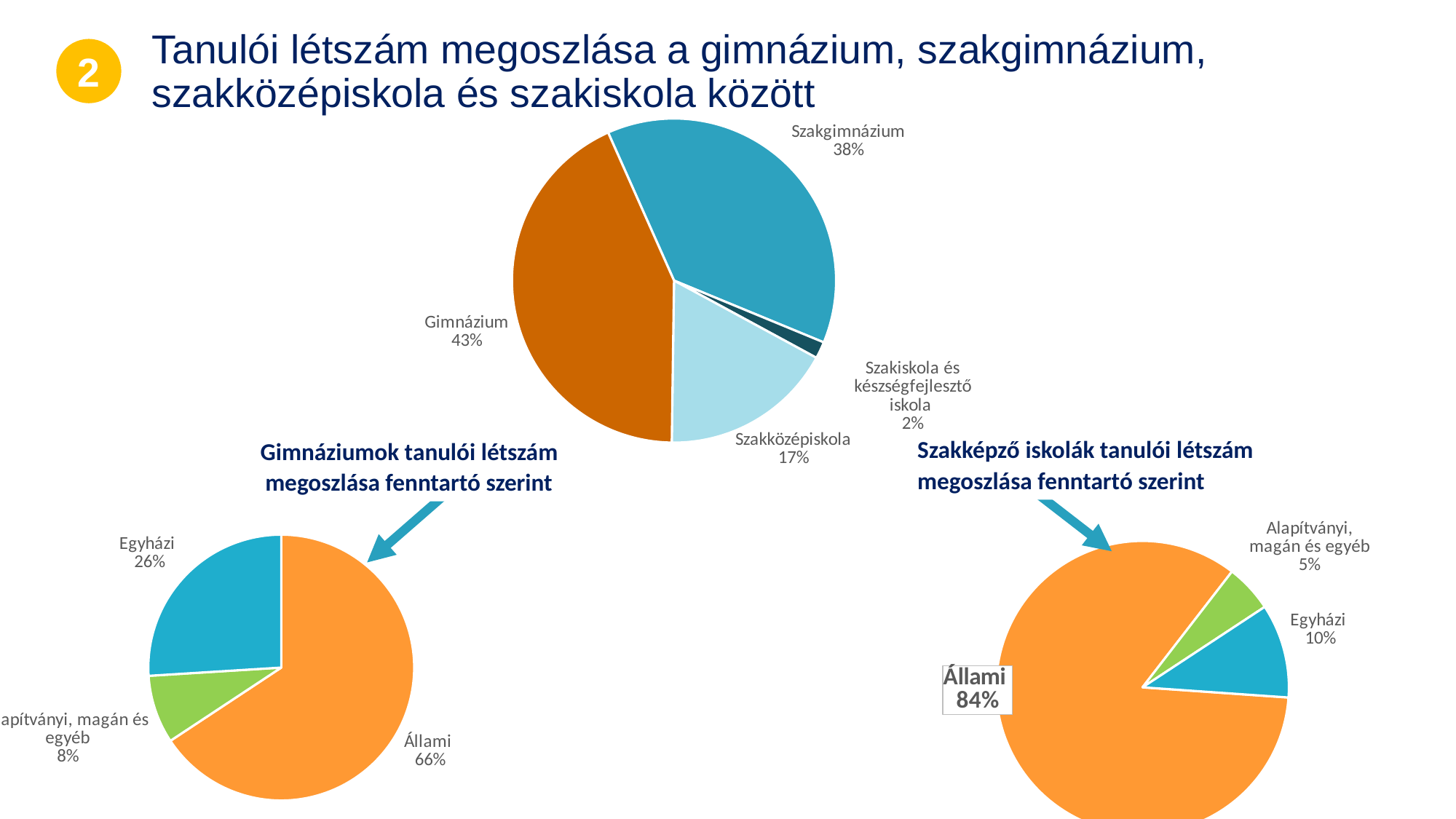
In the chart 'Gimnáziumok tanulói létszám megoszlása fenntartó szerint', what share is Egyházi? 26% In the top pie chart, which category has the largest share? Gimnázium How many slices does the top pie chart have? 4 In the top pie chart, what share of students is in Gimnázium? 43% How many pie charts are shown on the slide? 3 In the top pie chart, what share of students is in Szakgimnázium? 38% In the top pie chart, what is the difference in percentage points between Gimnázium and Szakközépiskola? 26 In the chart 'Szakképző iskolák tanulói létszám megoszlása fenntartó szerint', which is larger, Egyházi or Alapítványi, magán és egyéb? Egyházi What type of chart is used for 'Szakképző iskolák tanulói létszám megoszlása fenntartó szerint'? Pie chart In the top pie chart, which category has the smallest share? Szakiskola és készségfejlesztő iskola